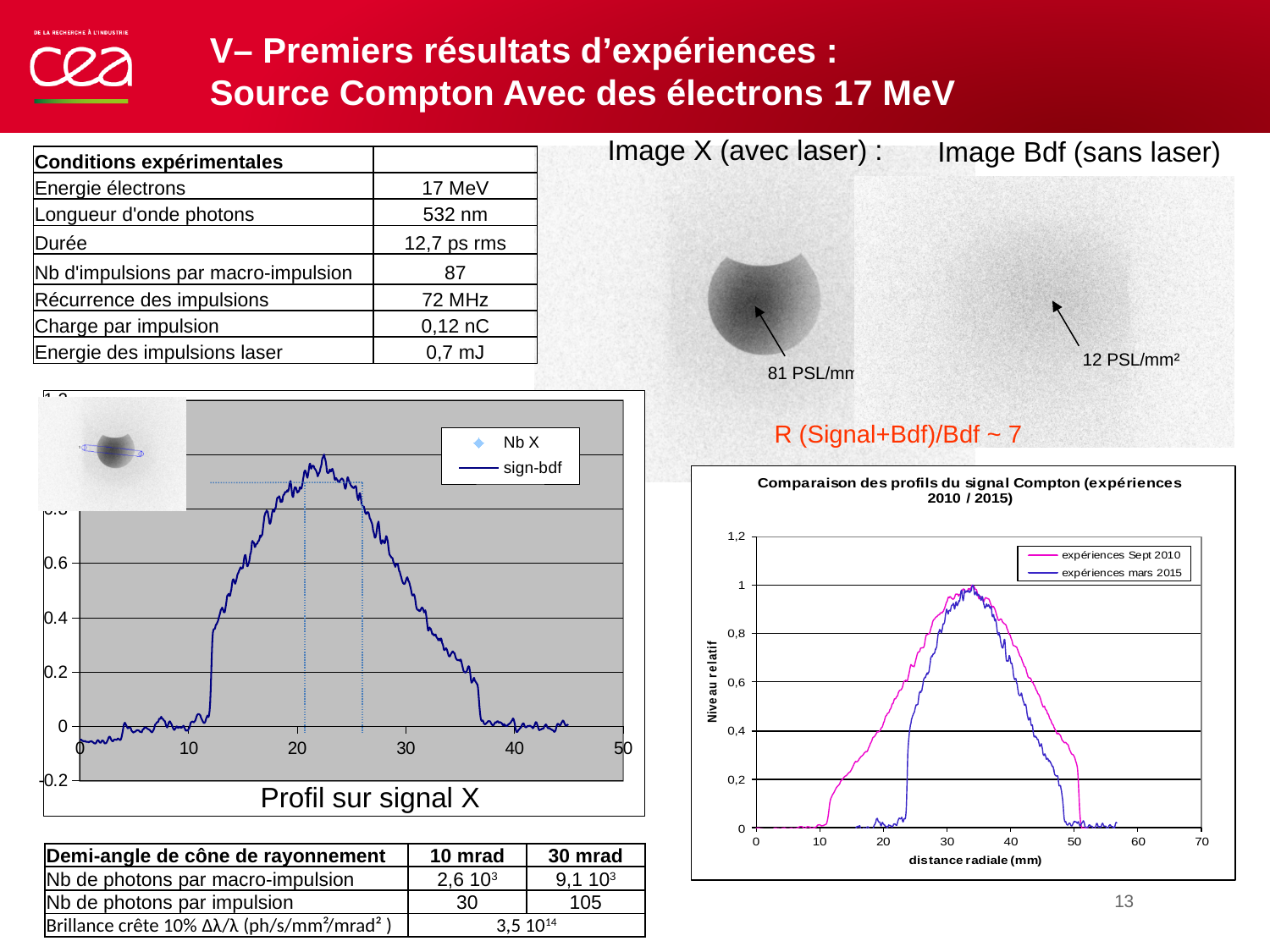
What kind of chart is the chart titled 'Profil sur signal X'? line chart In the chart titled 'Comparaison des profils du signal Compton (expériences 2010 / 2015)', at a radial distance of 20 mm, is the value for 'expériences mars 2015' greater or less than 0,2? less How many series does the legend list in the chart titled 'Profil sur signal X'? 2 What kind of chart is the chart titled 'Comparaison des profils du signal Compton (expériences 2010 / 2015)'? line chart In the chart titled 'Profil sur signal X', at x = 30, is the value of the 'sign-bdf' curve greater or less than 0.4? greater How many series does the legend list in the chart titled 'Comparaison des profils du signal Compton (expériences 2010 / 2015)'? 2 In the chart titled 'Comparaison des profils du signal Compton (expériences 2010 / 2015)', what is the largest tick value shown on the x axis? 70 In the chart titled 'Comparaison des profils du signal Compton (expériences 2010 / 2015)', at a radial distance of 20 mm, is the value for 'expériences Sept 2010' greater or less than 0,2? greater In the chart titled 'Comparaison des profils du signal Compton (expériences 2010 / 2015)', what are the two legend entries? expériences Sept 2010 and expériences mars 2015 In the chart titled 'Comparaison des profils du signal Compton (expériences 2010 / 2015)', what is the x-axis title? distance radiale (mm) In the chart titled 'Comparaison des profils du signal Compton (expériences 2010 / 2015)', at a radial distance of 20 mm, which series has the higher value? expériences Sept 2010